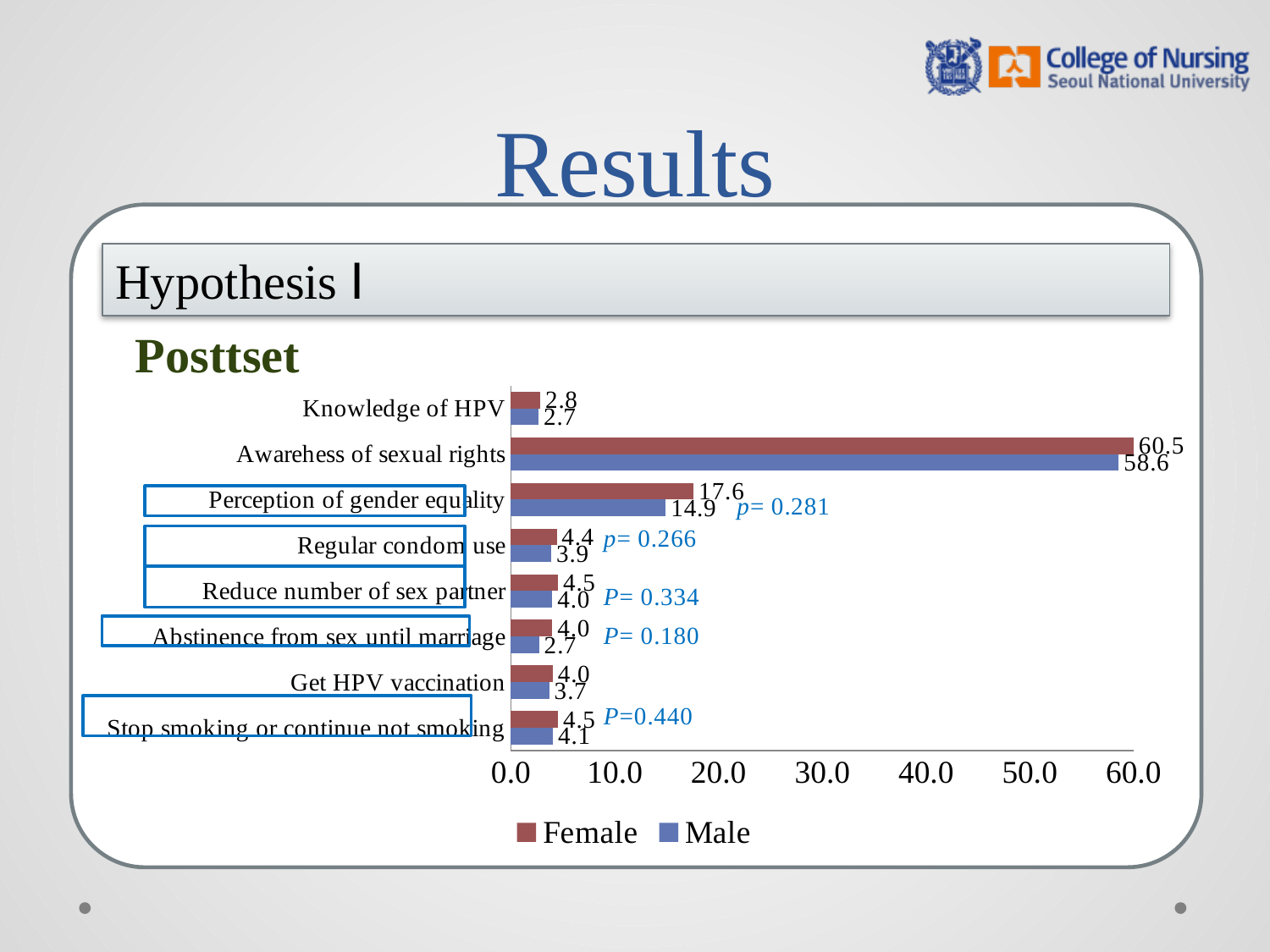
What kind of chart is shown on the slide? Bar chart What is the difference between the Female and Male values for Perception of gender equality? 2.7 How many series does the legend list? 2 How many categories are shown on the chart? 8 Which is larger for Regular condom use, the Female value or the Male value? Female What is the Female value for Stop smoking or continue not smoking? 4.5 Which category has the highest Female value? Awareness of sexual rights What is the Male value for Abstinence from sex until marriage? 2.7 Which category has the lowest Male value? Knowledge of HPV and Abstinence from sex until marriage (both 2.7) What is the Female value for Awareness of sexual rights? 60.5 What is the difference between the Female and Male values for Awareness of sexual rights? 1.9 What is the Male value for Perception of gender equality? 14.9